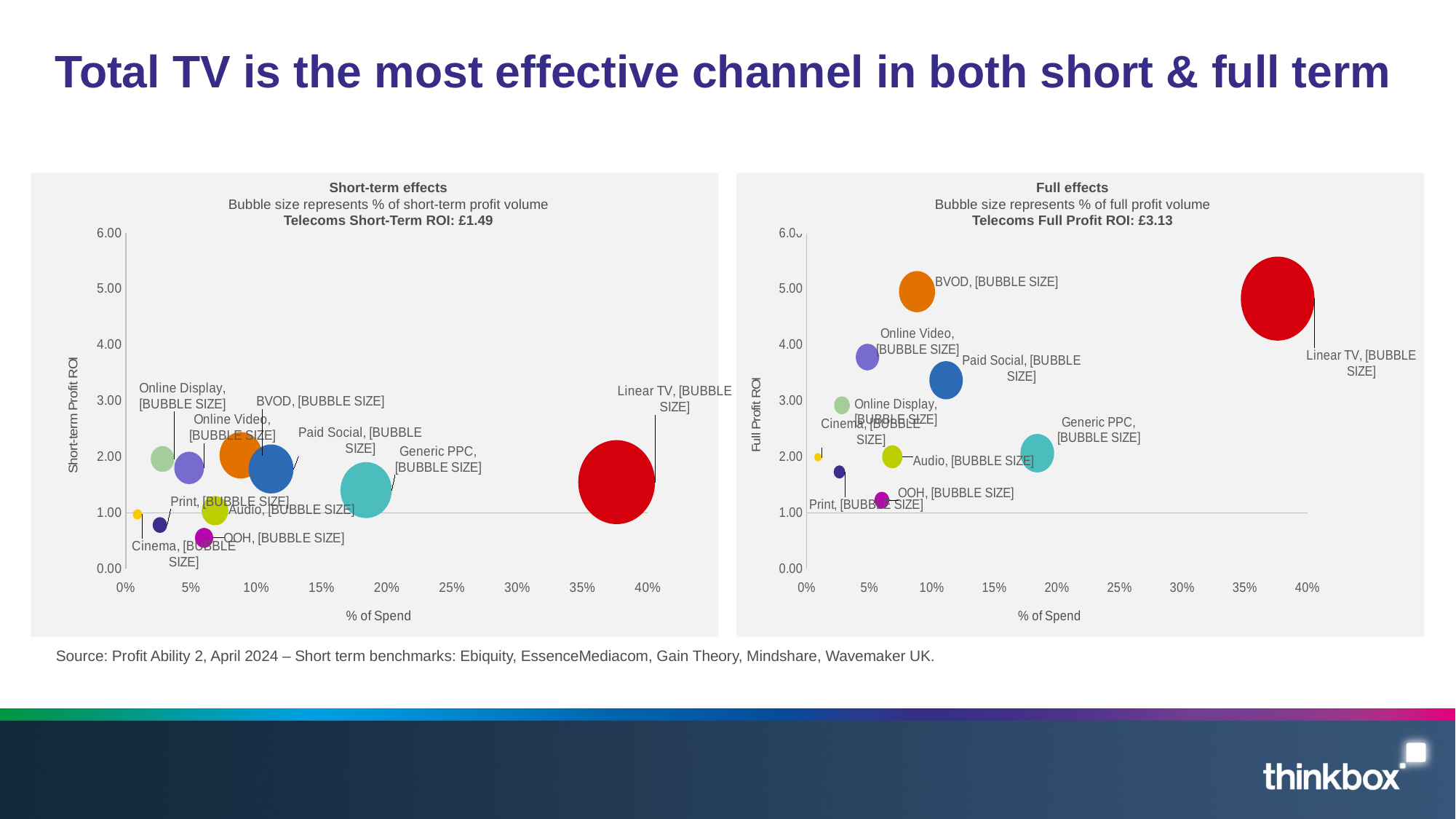
In the 'Short-term effects' chart, which has the higher Short-term Profit ROI, BVOD or Audio? BVOD In the 'Short-term effects' chart, is the Short-term Profit ROI for Linear TV greater or less than 2.00? less In the 'Full effects' chart, which has the higher Full Profit ROI, Online Video or Paid Social? Online Video In the 'Full effects' chart, which channel has the highest % of spend on the x axis? Linear TV In the 'Short-term effects' chart, is the Short-term Profit ROI for OOH greater or less than 1.00? less In the 'Full effects' chart, is the Full Profit ROI for Paid Social greater or less than 3.00? greater In the 'Full effects' chart, which channel has the lowest Full Profit ROI? OOH In the 'Short-term effects' chart, how many channels are plotted as bubbles? 10 What Telecoms Full Profit ROI is stated in the title of the 'Full effects' chart? £3.13 What kind of chart is the 'Short-term effects' chart? Bubble chart What Telecoms Short-Term ROI is stated in the title of the 'Short-term effects' chart? £1.49